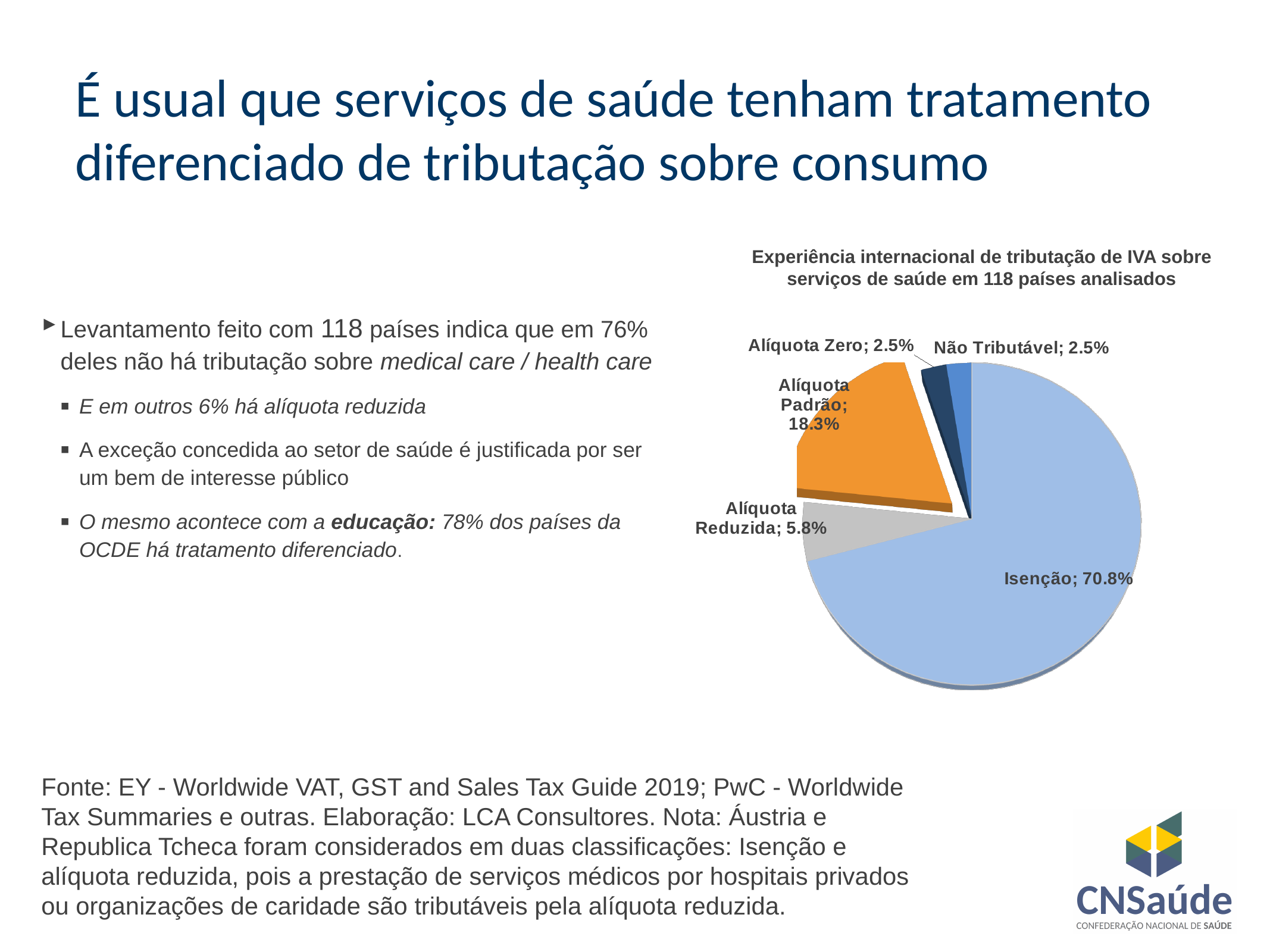
What type of chart is shown on the slide? Pie chart What is the share for Alíquota Zero in the pie chart? 2.5% Which is larger, the share for Alíquota Padrão or the share for Alíquota Reduzida? Alíquota Padrão What is the difference in percentage points between Isenção and Alíquota Padrão? 52.5 How many slices does the pie chart have? 5 What is the share for Não Tributável in the pie chart? 2.5% What is the title of the pie chart? Experiência internacional de tributação de IVA sobre serviços de saúde em 118 países analisados What is the share for Alíquota Reduzida in the pie chart? 5.8% Which category has the largest slice in the pie chart? Isenção What is the share for Isenção in the pie chart? 70.8% What colour is the Alíquota Padrão slice in the pie chart? Orange What is the share for Alíquota Padrão in the pie chart? 18.3%